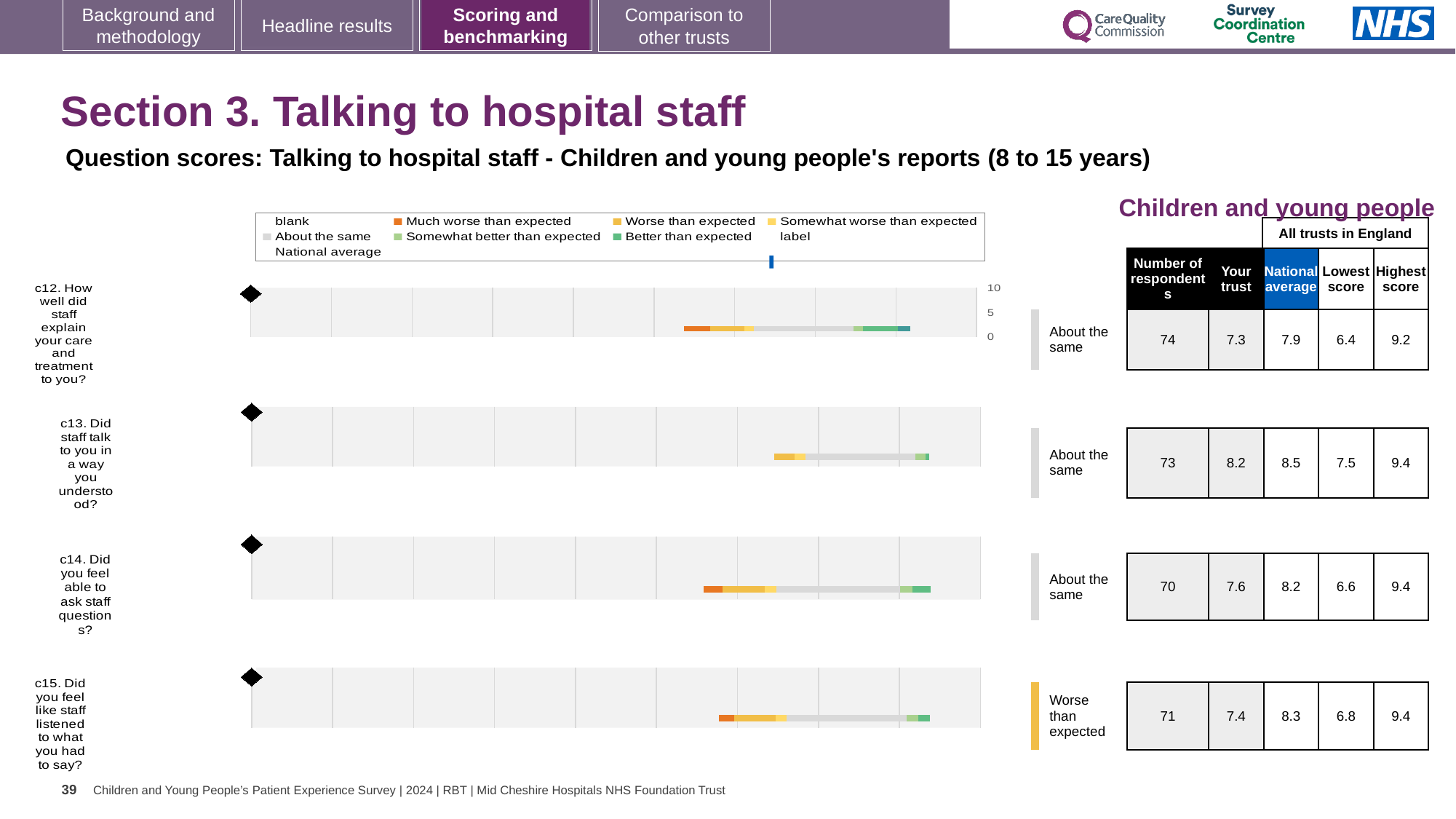
What is the number of respondents for c14 (Did you feel able to ask staff questions?)? 70 For c14, which is larger: the 'Your trust' score or the national average? National average What is the 'Your trust' score for c12 (How well did staff explain your care and treatment to you?)? 7.3 What benchmark category is shown for c15 (Did you feel like staff listened to what you had to say?)? Worse than expected What is the national average score for c13 (Did staff talk to you in a way you understood?)? 8.5 Which question has the highest 'Your trust' score? c13 What is the highest score across all trusts in England for c12? 9.2 What is the lowest score across all trusts in England for c15 (Did you feel like staff listened to what you had to say?)? 6.8 What kind of chart is used to show the benchmarking results for each question on this slide? bar chart How many survey questions (c12 to c15) are plotted on this slide? 4 Which question has the lowest 'Your trust' score? c12 For c12, what is the difference between the national average and the 'Your trust' score? 0.6